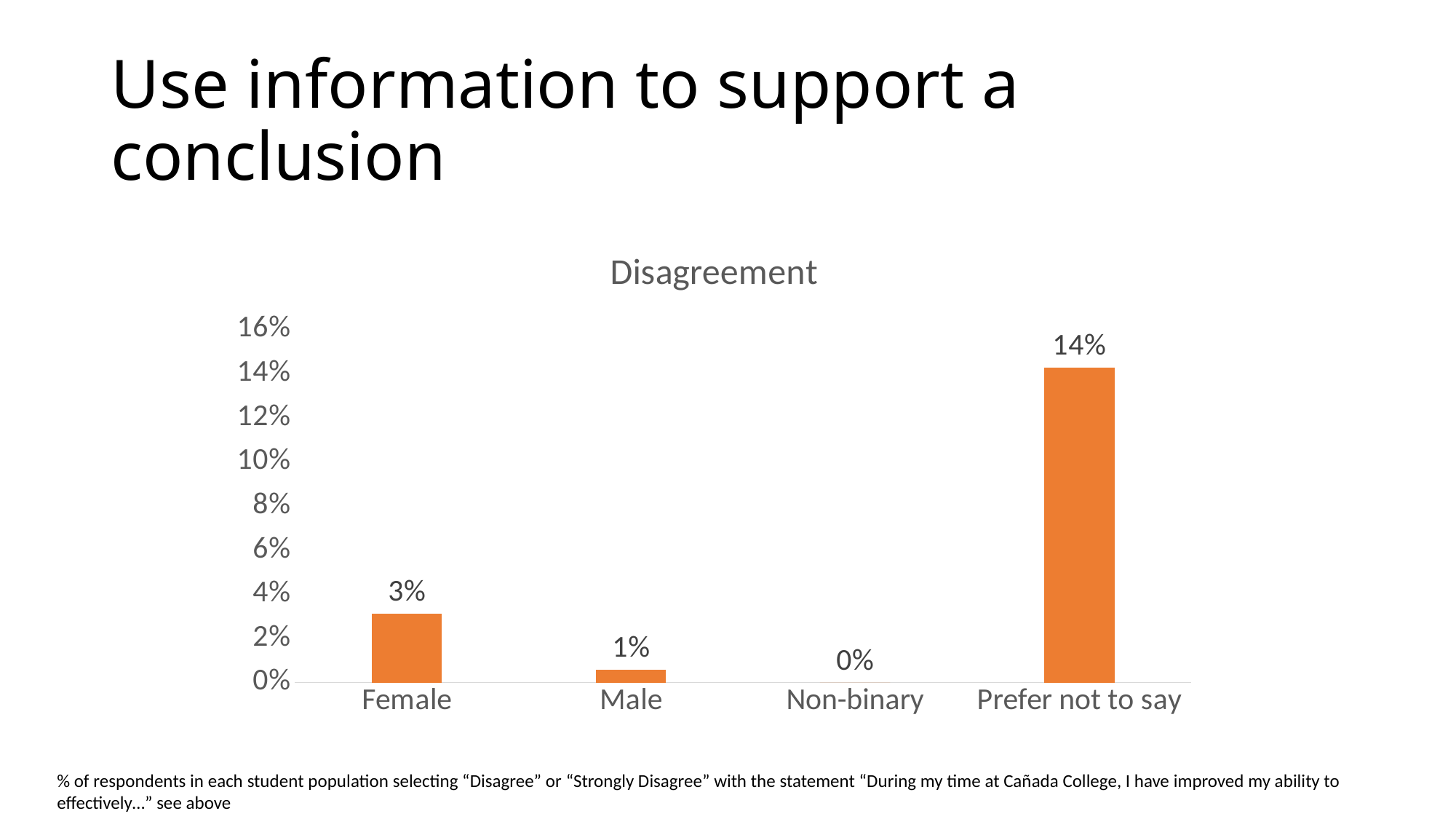
Which is larger, the value for Female or the value for Male? Female What is the title of the chart? Disagreement What kind of chart is shown on the slide? bar chart What is the value for Male? 1% What is the value for Prefer not to say? 14% Which category has the highest value? Prefer not to say What is the difference between the values for Prefer not to say and Female? 11% What is the value for Non-binary? 0% What is the value for Female? 3% How many categories are shown on the x axis? 4 Which category has the lowest value? Non-binary Is the value for Prefer not to say greater or less than 10%? greater